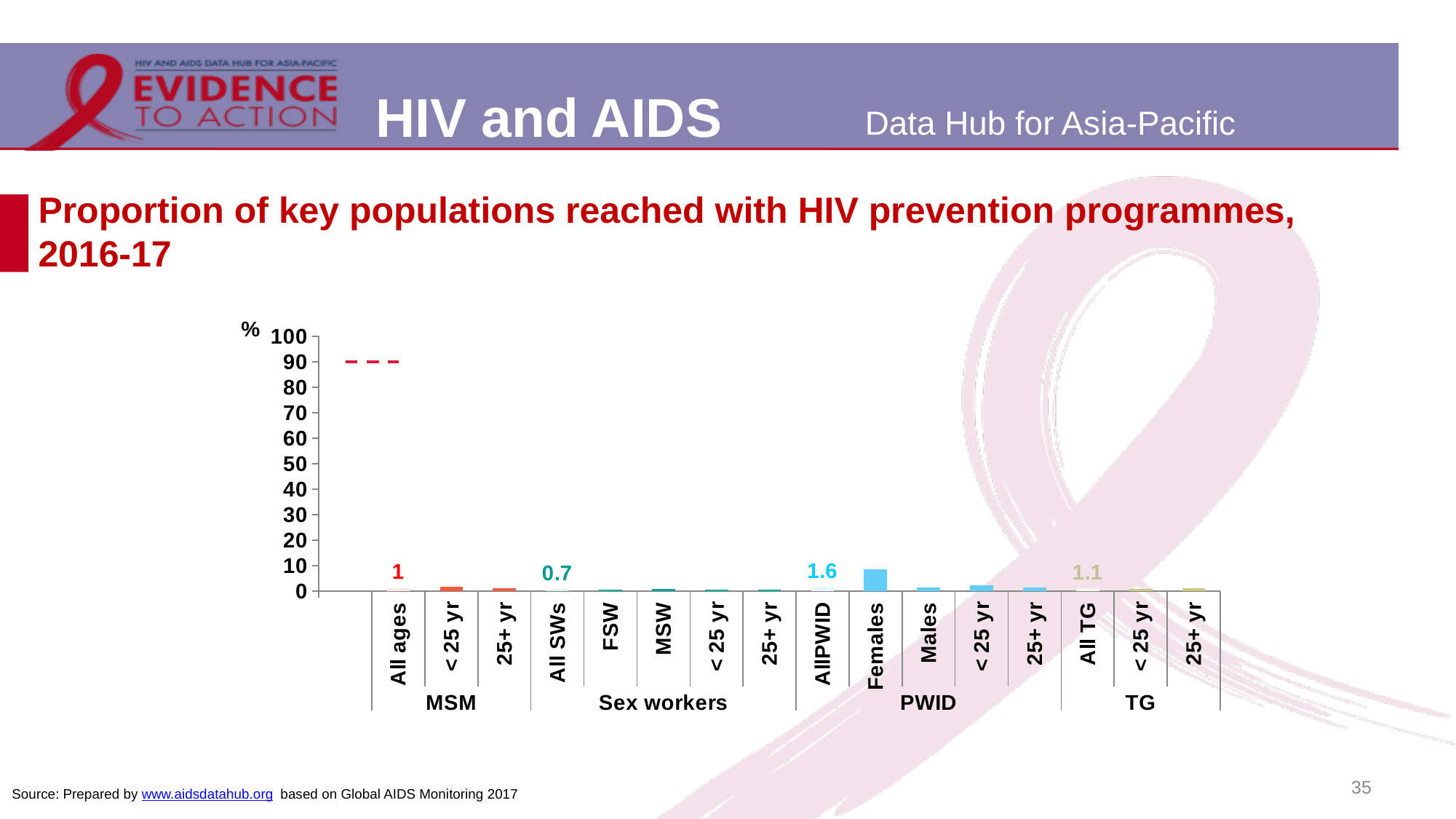
What is the value for All SWs under Sex workers? 0.7 What is the difference between the value for All PWID and the value for All SWs? 0.9 Among the four labelled 'All' bars (All ages MSM, All SWs, All PWID, All TG), which has the lowest value? All SWs What is the value for All PWID? 1.6 At what value on the y axis is the red dashed line drawn? 90 How many key population groups are labelled along the x axis (MSM, Sex workers, PWID, TG)? 4 What is the value for All ages under MSM? 1 Is the value for Females under PWID greater or less than 20? less What kind of chart is shown on the slide? bar chart What is the value for All TG? 1.1 Among the four labelled 'All' bars (All ages MSM, All SWs, All PWID, All TG), which has the highest value? All PWID Which is larger, the value for All TG or the value for All SWs? All TG